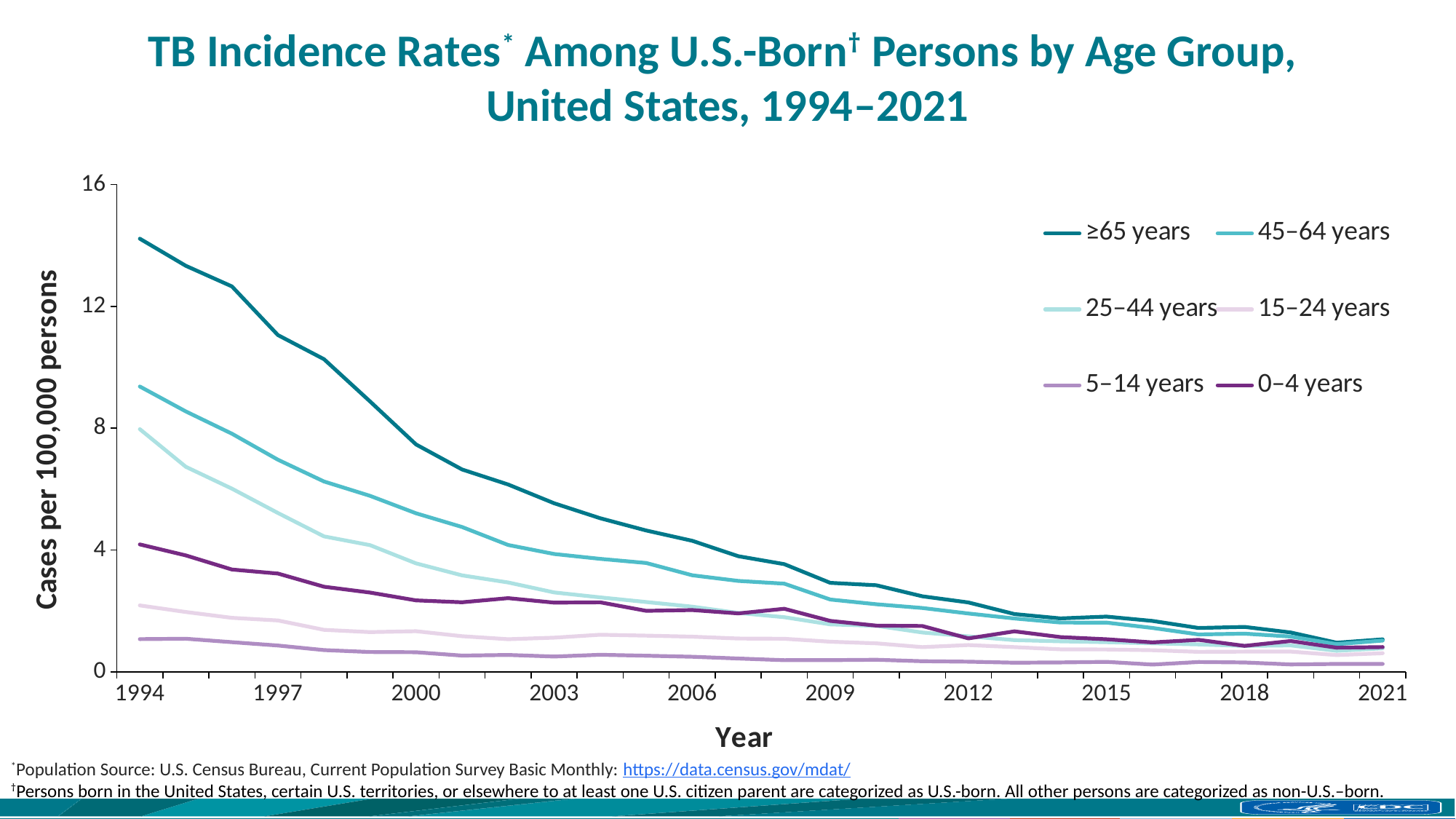
Which age group has the highest TB incidence rate in 1994? ≥65 years What is the label of the y axis? Cases per 100,000 persons How many years are plotted along the x axis, from 1994 to 2021? 28 Does the TB incidence rate for ≥65 years rise or fall from 1994 to 2021? fall Is the value for ≥65 years in 2009 greater or less than 4? less Which age group has the lowest TB incidence rate in 1994? 5–14 years Is the value for 45–64 years in 1994 greater or less than 8? greater What kind of chart is shown on the slide? line chart How many series does the legend list? 6 Which is larger in 1994, the rate for ≥65 years or the rate for 45–64 years? ≥65 years Is the value for 5–14 years in 1994 greater or less than 4? less